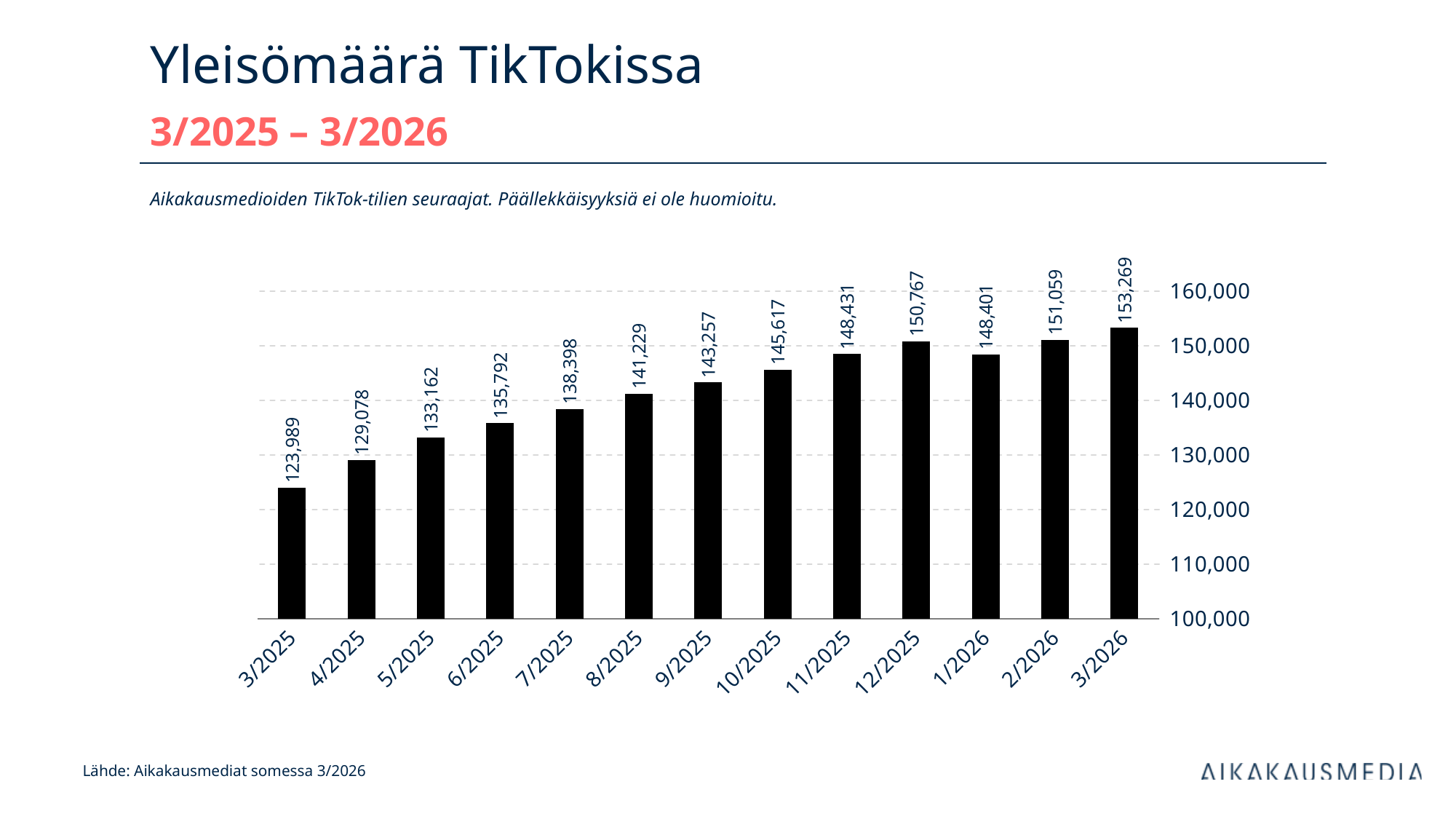
Which month has the highest value? 3/2026 What kind of chart is shown on the slide? bar chart Is the value for 6/2025 greater or less than 140,000? less What is the value for 3/2025? 123,989 Do the values generally rise or fall from 3/2025 to 3/2026? rise What is the value for 12/2025? 150,767 What is the difference between the values for 3/2026 and 3/2025? 29,280 What is the value for 1/2026? 148,401 Which is larger, the value for 8/2025 or the value for 10/2025? 10/2025 How many months are shown on the x axis? 13 Which month has the lowest value? 3/2025 What is the difference between the values for 12/2025 and 1/2026? 2,366